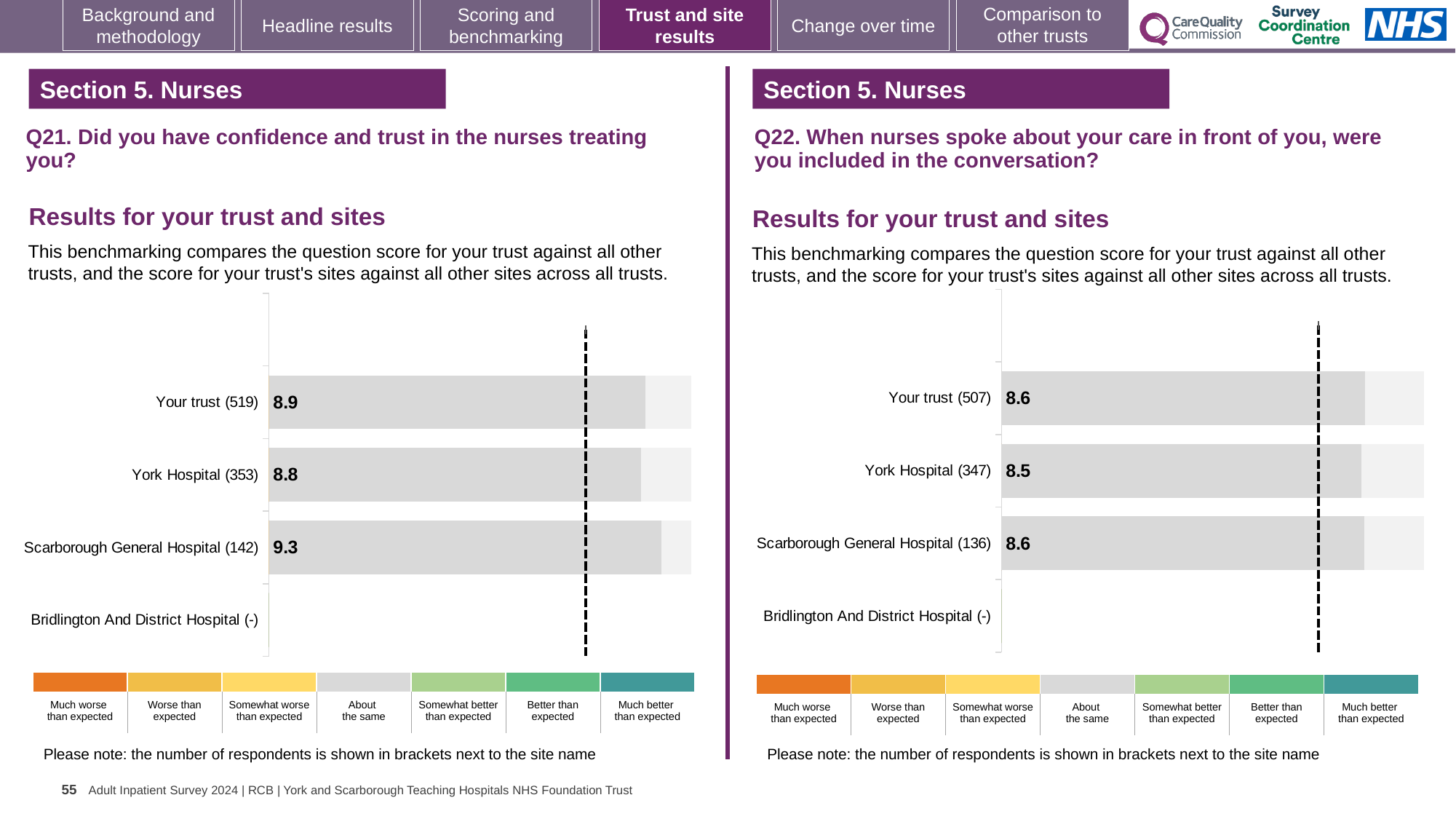
On the Q21 chart (left), how many respondents are shown in brackets for York Hospital? 353 On the Q22 chart (right), what is the score for Your trust? 8.6 How many rows (trust and sites) are listed on the Q21 chart (left)? 4 On the Q21 chart (left), what is the score for Scarborough General Hospital? 9.3 On the Q22 chart (right), what is the difference between the scores for Your trust and York Hospital? 0.1 What kind of chart is used on the Q22 chart (right)? Bar chart On the Q21 chart (left), which site or trust has the highest score? Scarborough General Hospital On the Q22 chart (right), which site has the lowest printed score? York Hospital On the Q22 chart (right), what is the score for York Hospital? 8.5 On the Q22 chart (right), how many respondents are shown in brackets for Scarborough General Hospital? 136 On the Q21 chart (left), what is the difference between the scores for Scarborough General Hospital and York Hospital? 0.5 On the Q21 chart (left), what is the score for Your trust? 8.9